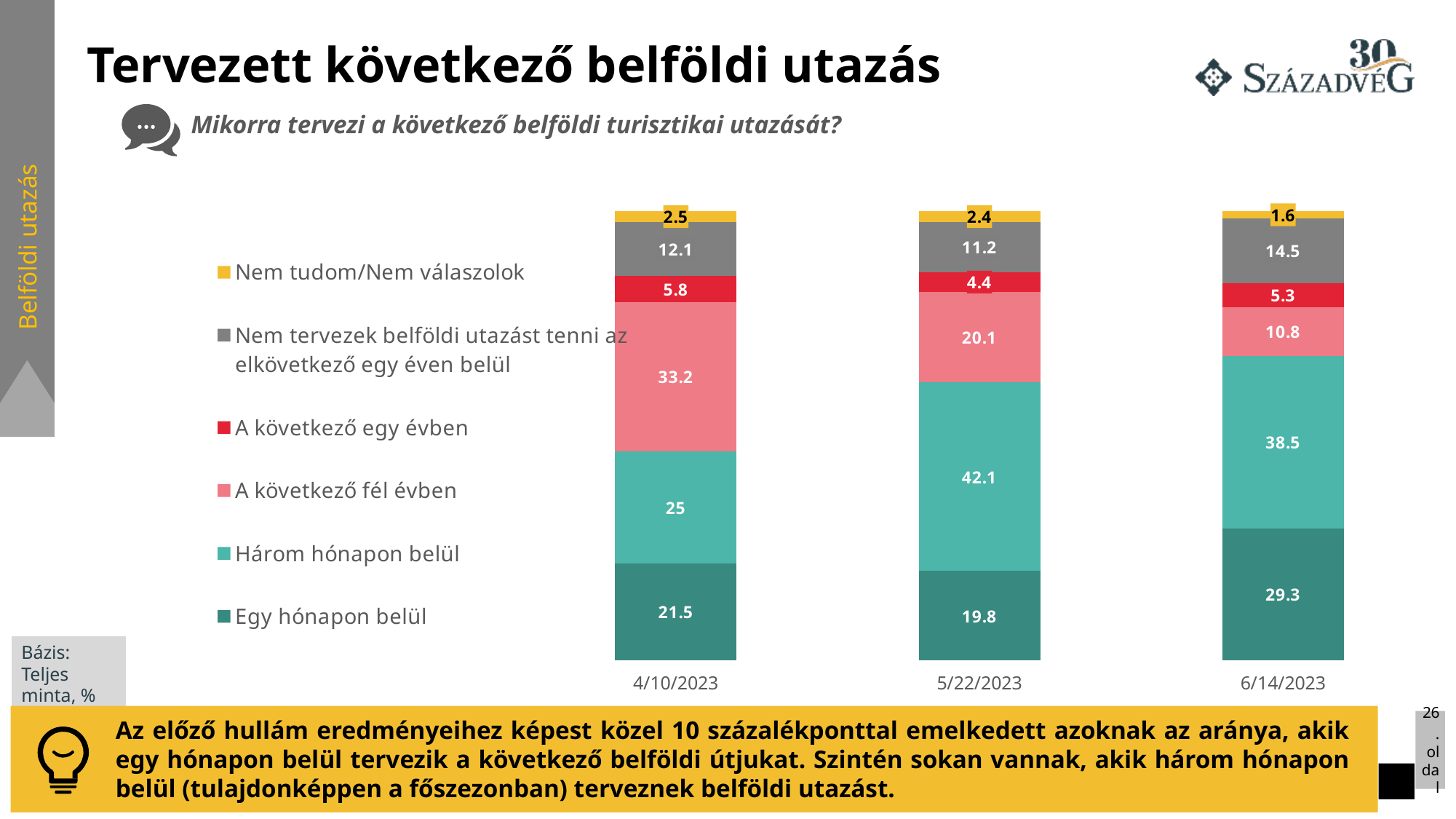
On which date is the value for "A következő fél évben" the lowest? 6/14/2023 What is the total of the stacked bar for 5/22/2023? 100 What is the value for "Egy hónapon belül" on 6/14/2023? 29.3 What is the value for "A következő fél évben" on 4/10/2023? 33.2 What is the value for "Három hónapon belül" on 5/22/2023? 42.1 What kind of chart is shown on the slide? Stacked bar chart How many dates are shown on the x axis? 3 Which is larger on 4/10/2023: "Három hónapon belül" or "A következő fél évben"? A következő fél évben What is the difference between the "Egy hónapon belül" values on 6/14/2023 and 5/22/2023? 9.5 How many series does the legend list? 6 On which date is the value for "Egy hónapon belül" the highest? 6/14/2023 What is the value for "Nem tudom/Nem válaszolok" on 6/14/2023? 1.6